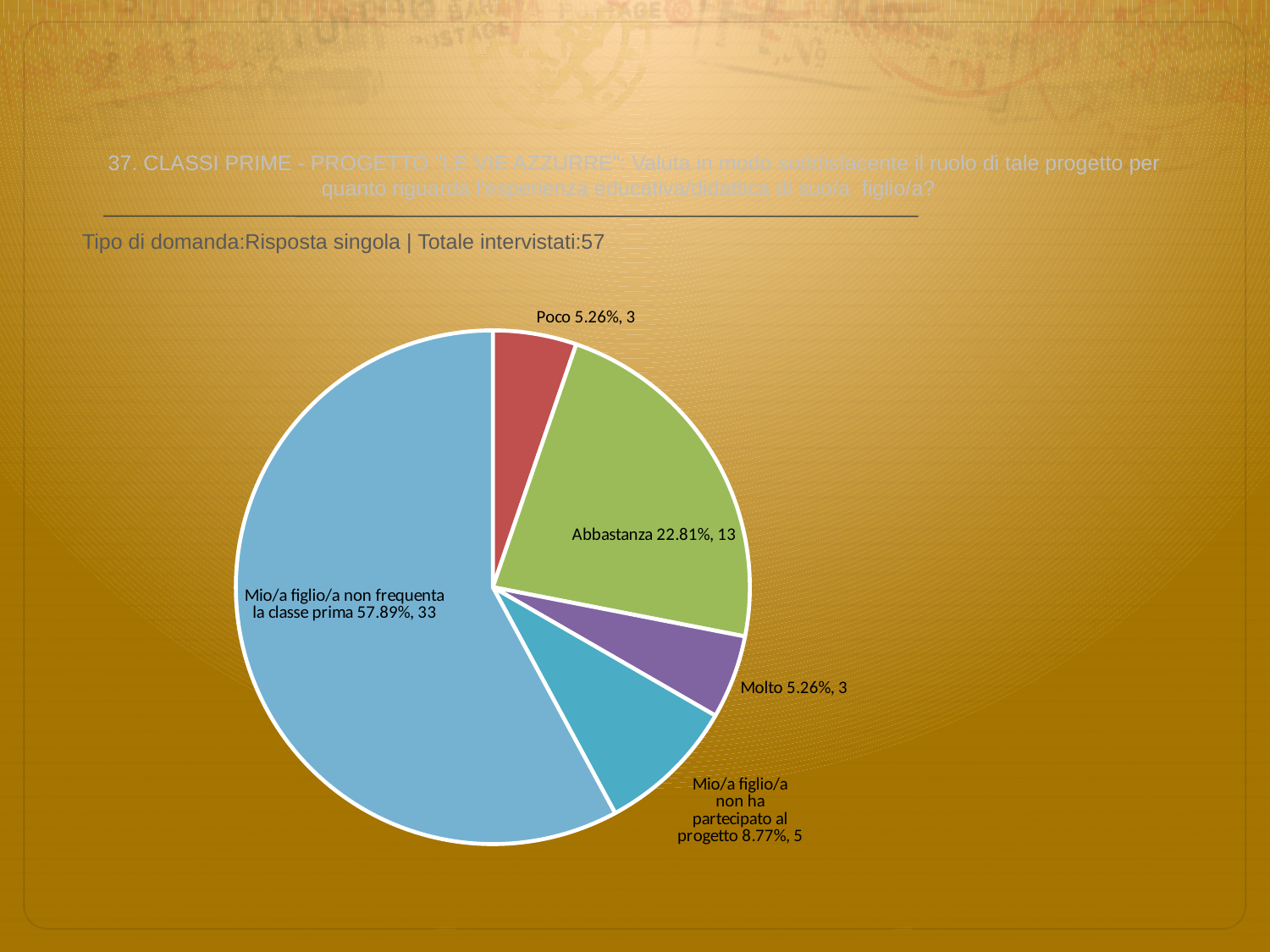
What percentage is shown for the "Molto" slice? 5.26% According to the text above the chart, what is the total number of respondents (Totale intervistati)? 57 What is the count shown for "Mio/a figlio/a non frequenta la classe prima"? 33 What percentage share does the "Abbastanza" slice represent? 22.81% What kind of chart is shown on the slide? Pie chart How many respondents chose "Abbastanza"? 13 How many slices does the pie chart have? 5 What percentage share does the "Mio/a figlio/a non ha partecipato al progetto" slice represent? 8.77% Which is larger, the count for "Abbastanza" or the count for "Mio/a figlio/a non ha partecipato al progetto"? Abbastanza Which category has the largest slice of the pie? Mio/a figlio/a non frequenta la classe prima How many respondents chose "Poco"? 3 What is the difference between the count for "Mio/a figlio/a non frequenta la classe prima" and the count for "Abbastanza"? 20